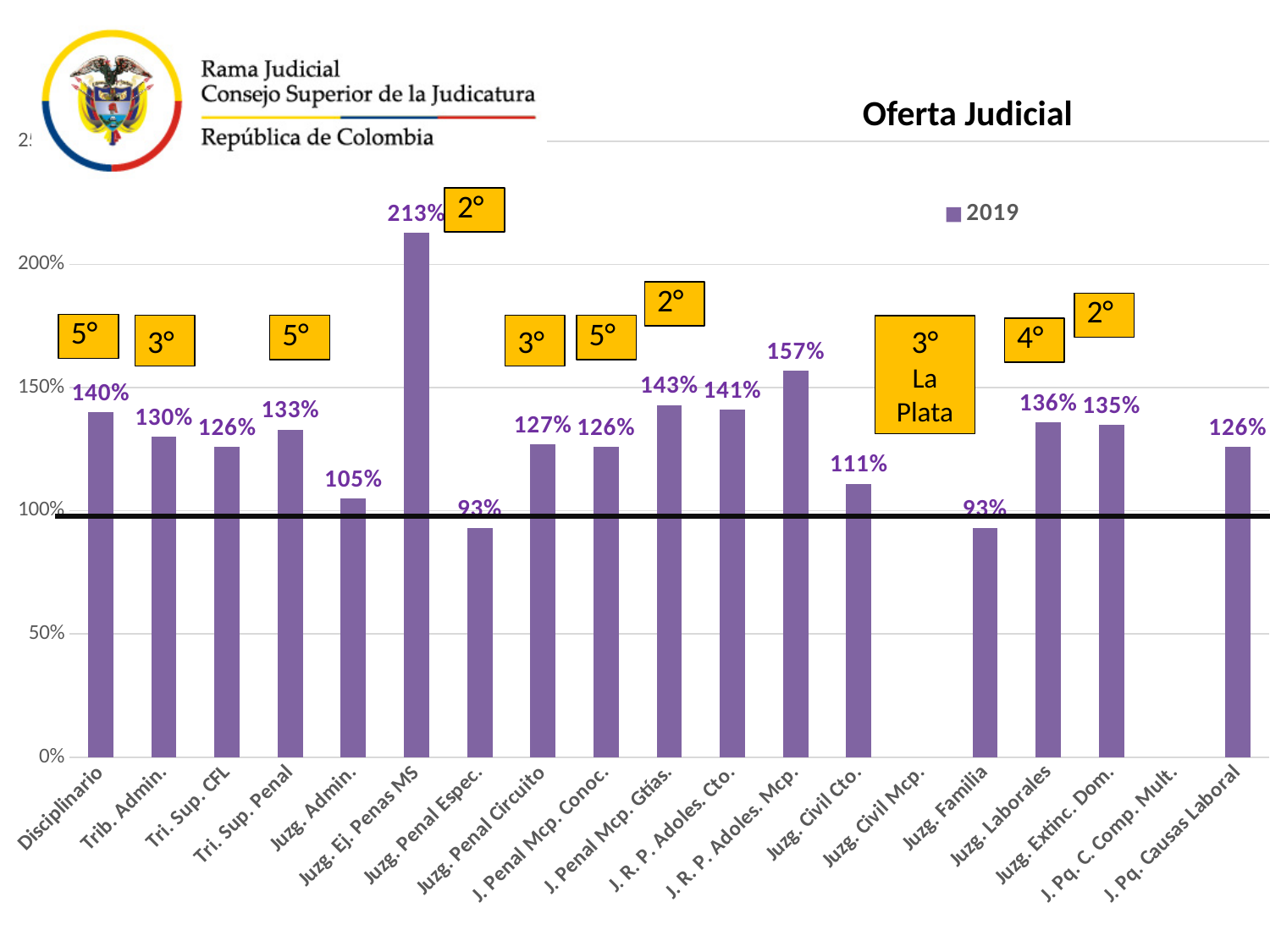
Which is larger, the value for Juzg. Laborales or the value for Juzg. Civil Cto.? Juzg. Laborales What is the value for Disciplinario? 140% How many categories are listed on the x axis? 19 What is the value for J. R. P. Adoles. Mcp.? 157% Which category has the highest value? Juzg. Ej. Penas MS Is the value for Juzg. Familia greater or less than 100%? less What is the value for Juzg. Ej. Penas MS? 213% What is the value for Juzg. Civil Cto.? 111% What is the difference between the values for Juzg. Ej. Penas MS and J. R. P. Adoles. Mcp.? 56% What is the difference between the values for Disciplinario and Juzg. Admin.? 35% What kind of chart is shown on the slide? bar chart What series does the legend list? 2019